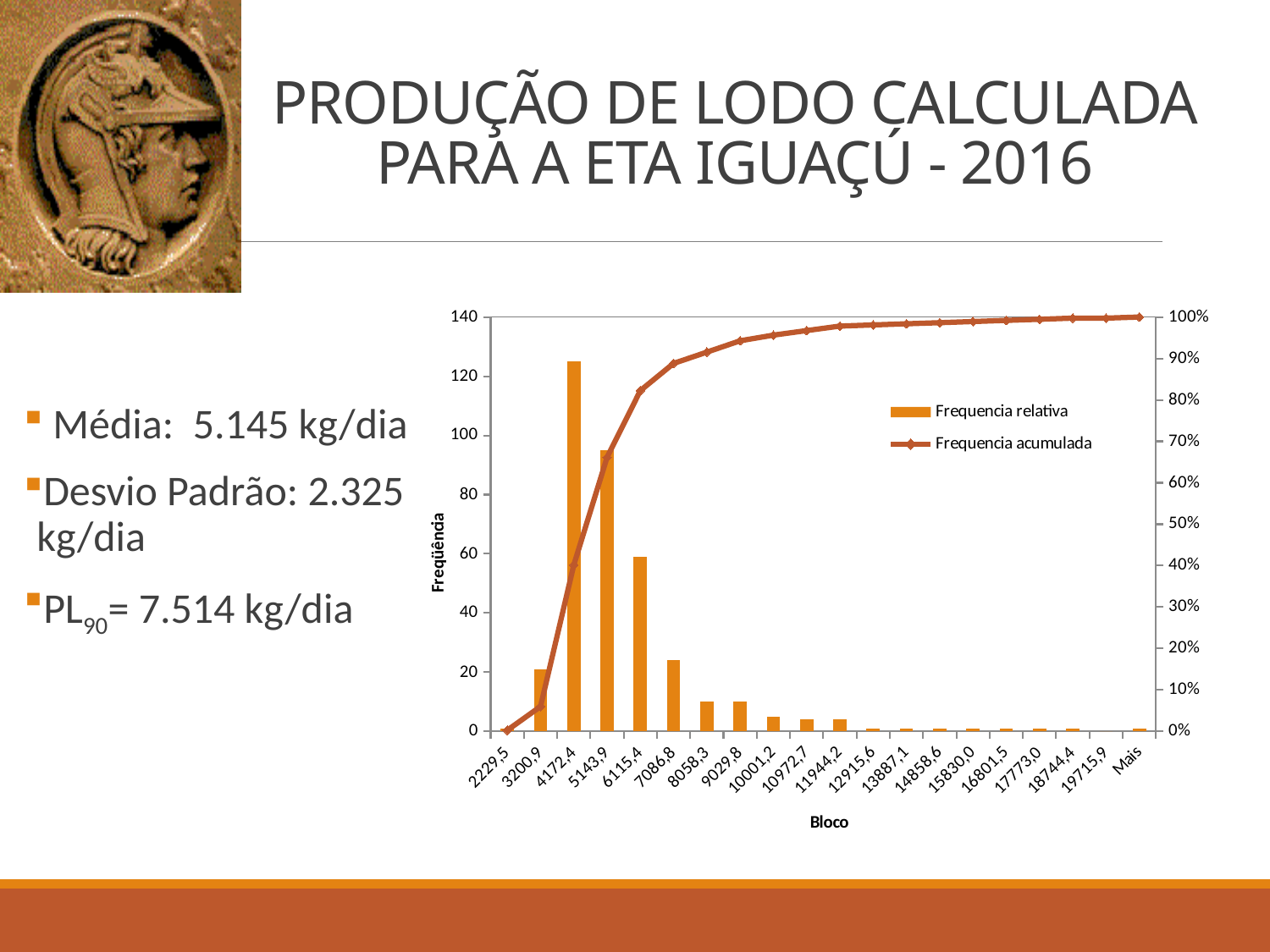
Which bloco has the highest Frequencia relativa bar? 4172,4 Which has the larger Frequencia relativa bar, bloco 4172,4 or bloco 5143,9? 4172,4 Is the Frequencia relativa value for bloco 5143,9 greater or less than 80? greater What are the two series named in the legend? Frequencia relativa and Frequencia acumulada Does the Frequencia acumulada line rise or fall as the blocos increase along the x axis? It rises Is the Frequencia relativa value for bloco 4172,4 greater or less than 100? greater How many categories (blocos) are shown on the x axis? 20 What is the title of the x axis of the chart? Bloco What kind of chart is shown on the slide? A bar chart combined with a line chart How many series does the chart legend list? 2 Is the Frequencia relativa value for bloco 6115,4 greater or less than 40? greater